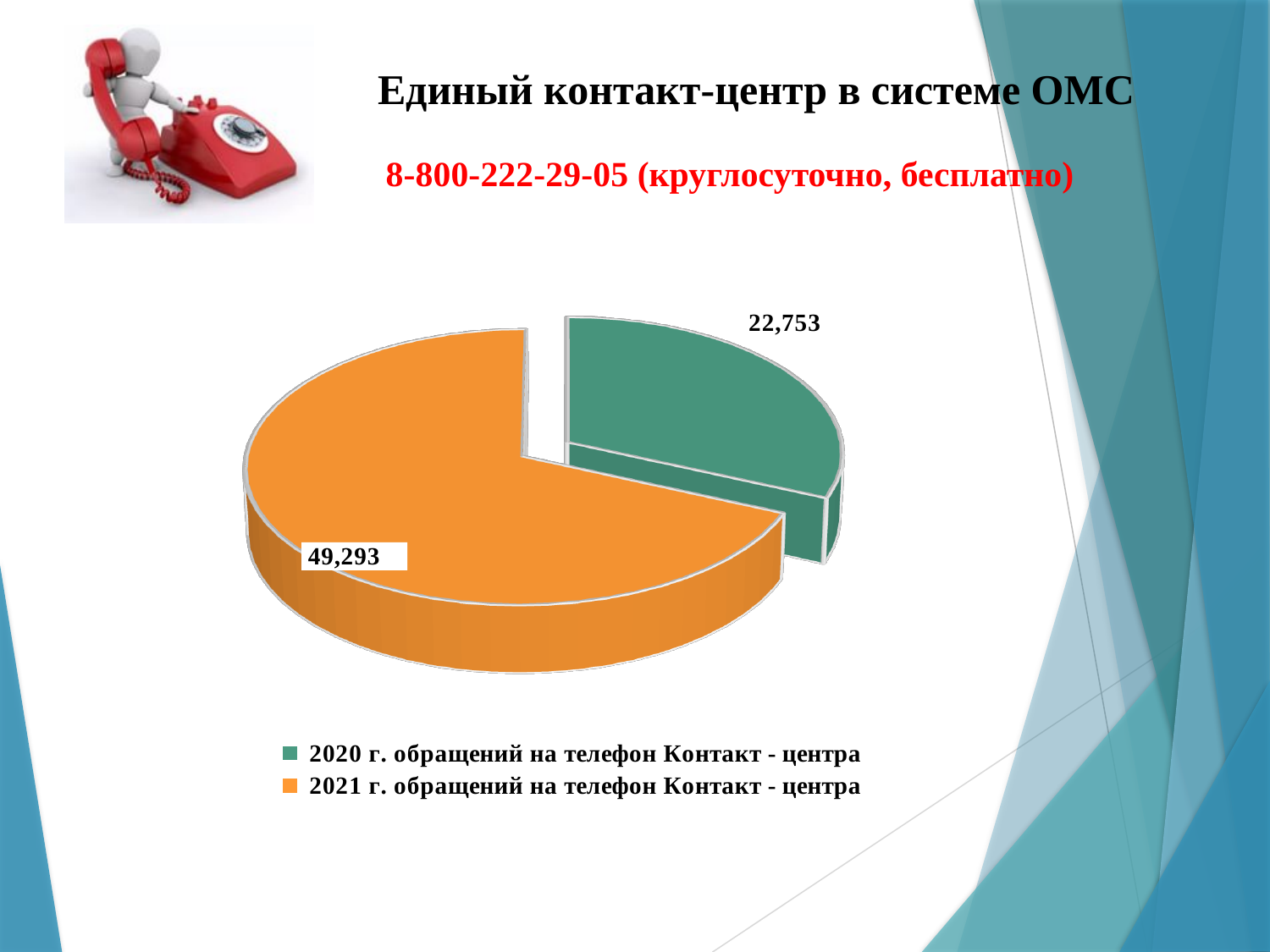
Which year has the smaller slice in the pie chart? 2020 Which year has the larger slice in the pie chart? 2021 What colour is the slice for 2020 calls to the Contact Center? Green What is the difference between the number of calls in 2021 and in 2020? 26,540 Were there more calls to the Contact Center in 2020 or in 2021? 2021 What is the total number of calls across both years shown in the pie chart? 72,046 How many slices does the pie chart have? 2 What type of chart is shown on the slide? Pie chart How many calls to the Contact Center phone were there in 2021 according to the chart? 49,293 What colour is the slice for 2021 calls to the Contact Center? Orange How many calls to the Contact Center phone were there in 2020 according to the chart? 22,753 How many entries does the legend list? 2